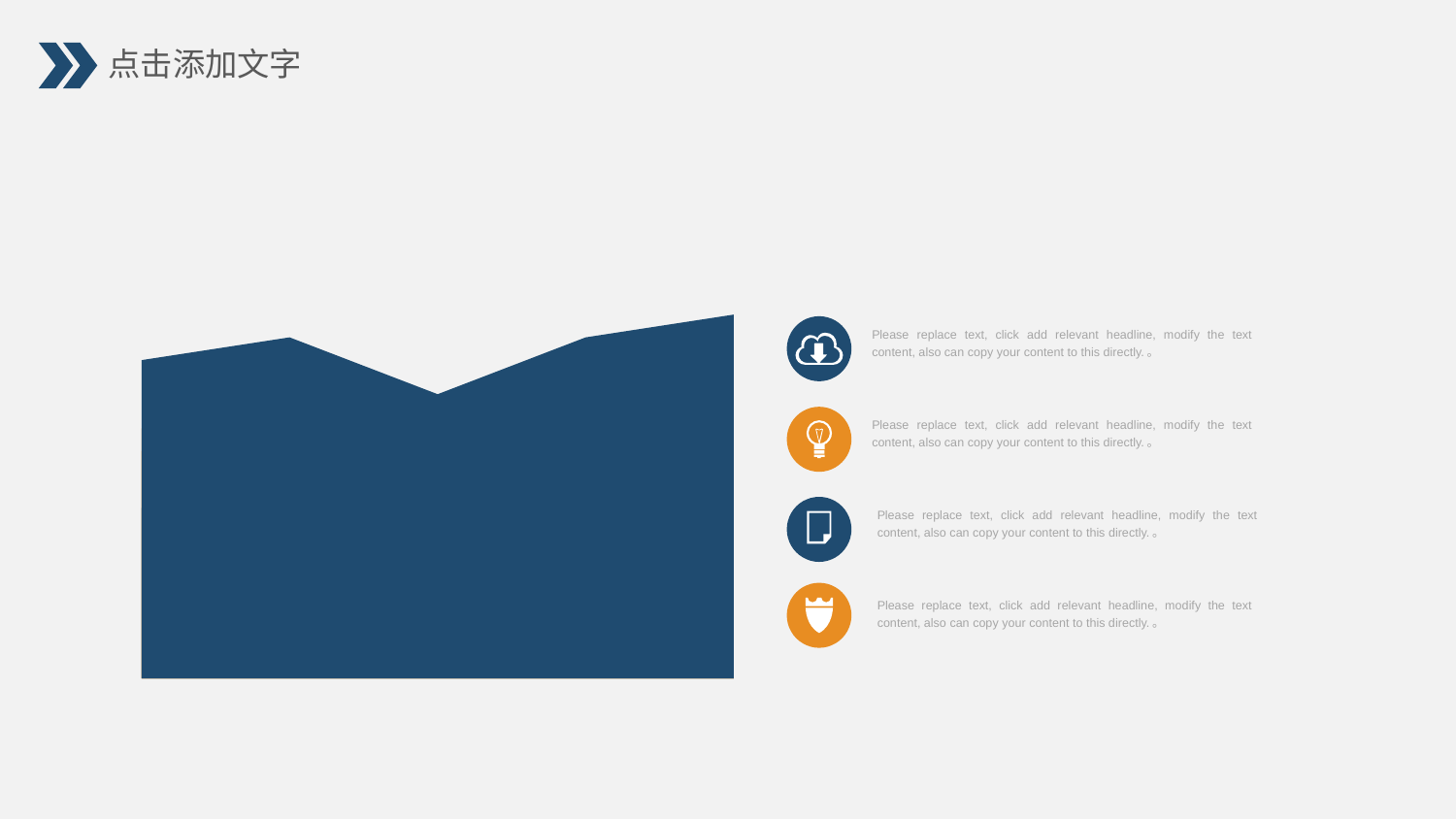
Between the second and third points, does the area chart rise or fall? fall Which data point of the area chart is the lowest? the third (middle) point Does the chart display any axis labels or data labels? No What kind of chart is shown on the left of the slide? area chart How many data points does the area chart's outline have? 5 What colour is the filled area of the chart? dark blue Is the last point of the area chart higher or lower than the first point? higher Between the third and fifth points, does the area chart rise or fall? rise Which data point of the area chart is the highest? the last (rightmost) point